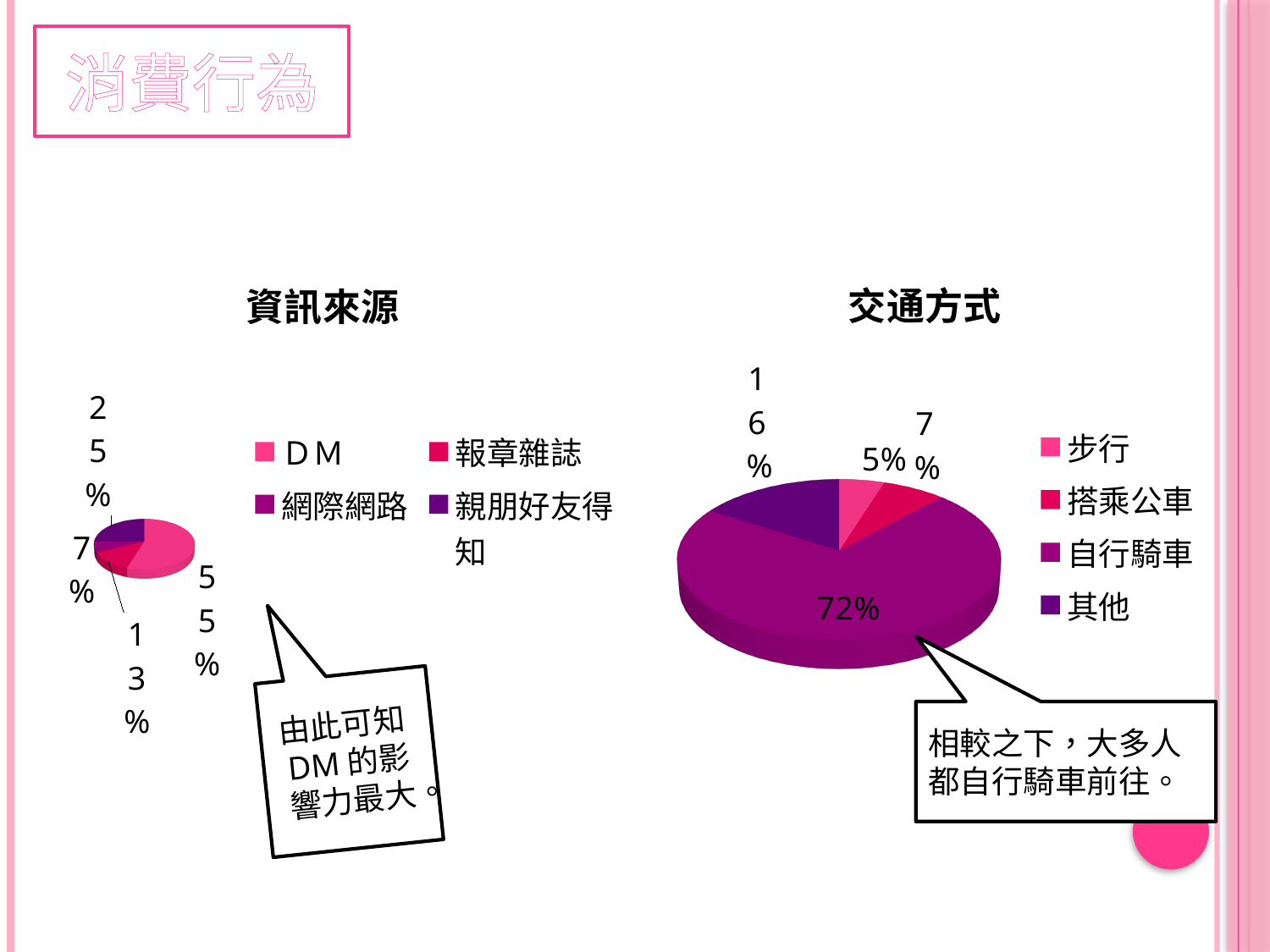
In the 交通方式 chart, what percentage is 自行騎車? 72% How many categories does the legend of the 資訊來源 chart list? 4 In the 資訊來源 chart, which category has the largest share? DM In the 交通方式 chart, which category has the smallest share? 步行 In the 交通方式 chart, which category has the largest share? 自行騎車 What type of chart is the 交通方式 chart? Pie chart In the 資訊來源 chart, what percentage is DM? 55% In the 交通方式 chart, what percentage is 步行? 5% In the 交通方式 chart, what is the difference between 自行騎車 and 其他? 56% In the 交通方式 chart, what percentage is 搭乘公車? 7% In the 交通方式 chart, which is larger, 搭乘公車 or 步行? 搭乘公車 In the 交通方式 chart, what percentage is 其他? 16%